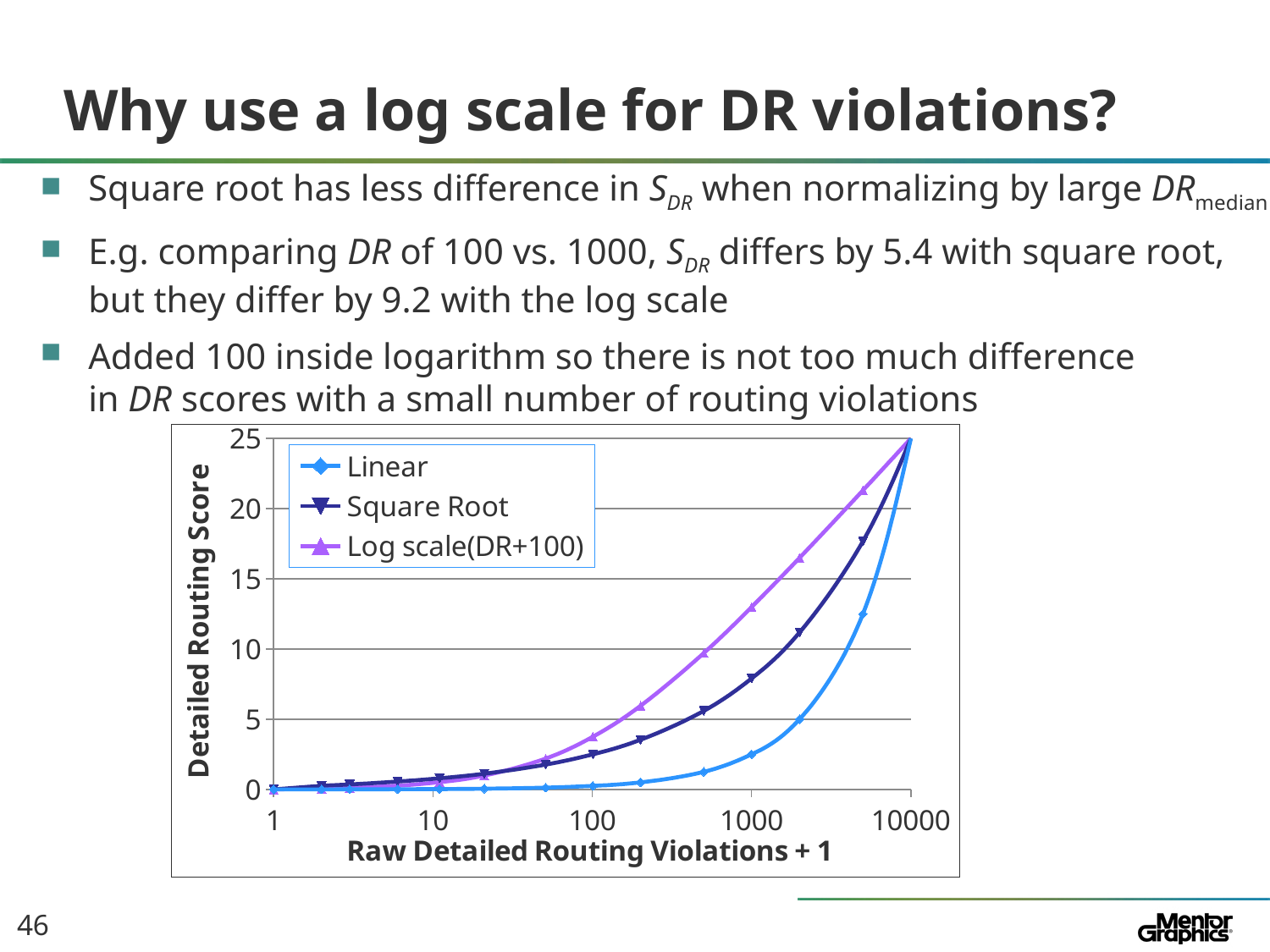
What is the title of the x axis? Raw Detailed Routing Violations + 1 Do the values of the Log scale(DR+100) series rise or fall as the x axis increases? Rise At x = 1000, which series has the highest Detailed Routing Score? Log scale(DR+100) At x = 1000, is the value for Linear greater or less than 5? less What is the title of the y axis? Detailed Routing Score How many series does the legend list? 3 At x = 1000, which series has the lowest Detailed Routing Score? Linear At x = 1000, is the value for Square Root greater or less than 10? less What type of chart is shown on the slide? Line chart At x = 1000, is the value for Log scale(DR+100) greater or less than 10? greater What Detailed Routing Score do all three series reach at x = 10000? 25